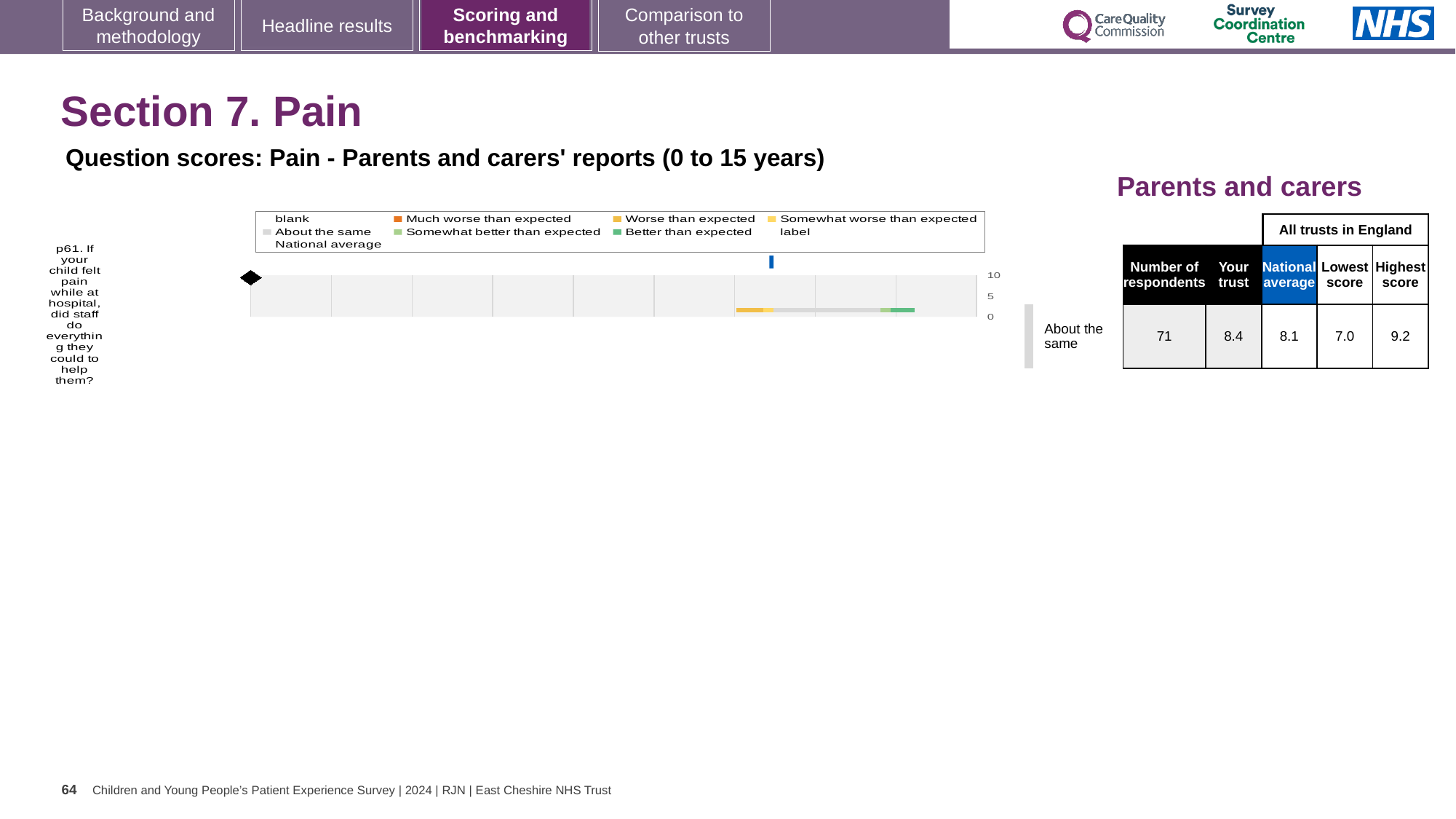
Which is larger for question p61: the 'Your trust' score or the national average? Your trust What is the highest tick value shown on the chart's score axis? 10 What is the difference between the highest score and the lowest score for question p61? 2.2 What benchmark category is the trust's result for question p61 placed in? About the same What is the difference between the 'Your trust' score and the national average for question p61? 0.3 How many respondents answered question p61, according to the table next to the chart? 71 According to the table next to the chart, what is the national average score for question p61? 8.1 According to the table next to the chart, what is the 'Your trust' score for question p61? 8.4 Which survey question is plotted in the chart? p61. If your child felt pain while at hospital, did staff do everything they could to help them? According to the table next to the chart, what is the highest score among all trusts in England for question p61? 9.2 According to the table next to the chart, what is the lowest score among all trusts in England for question p61? 7.0 What kind of chart is shown on the slide? bar chart